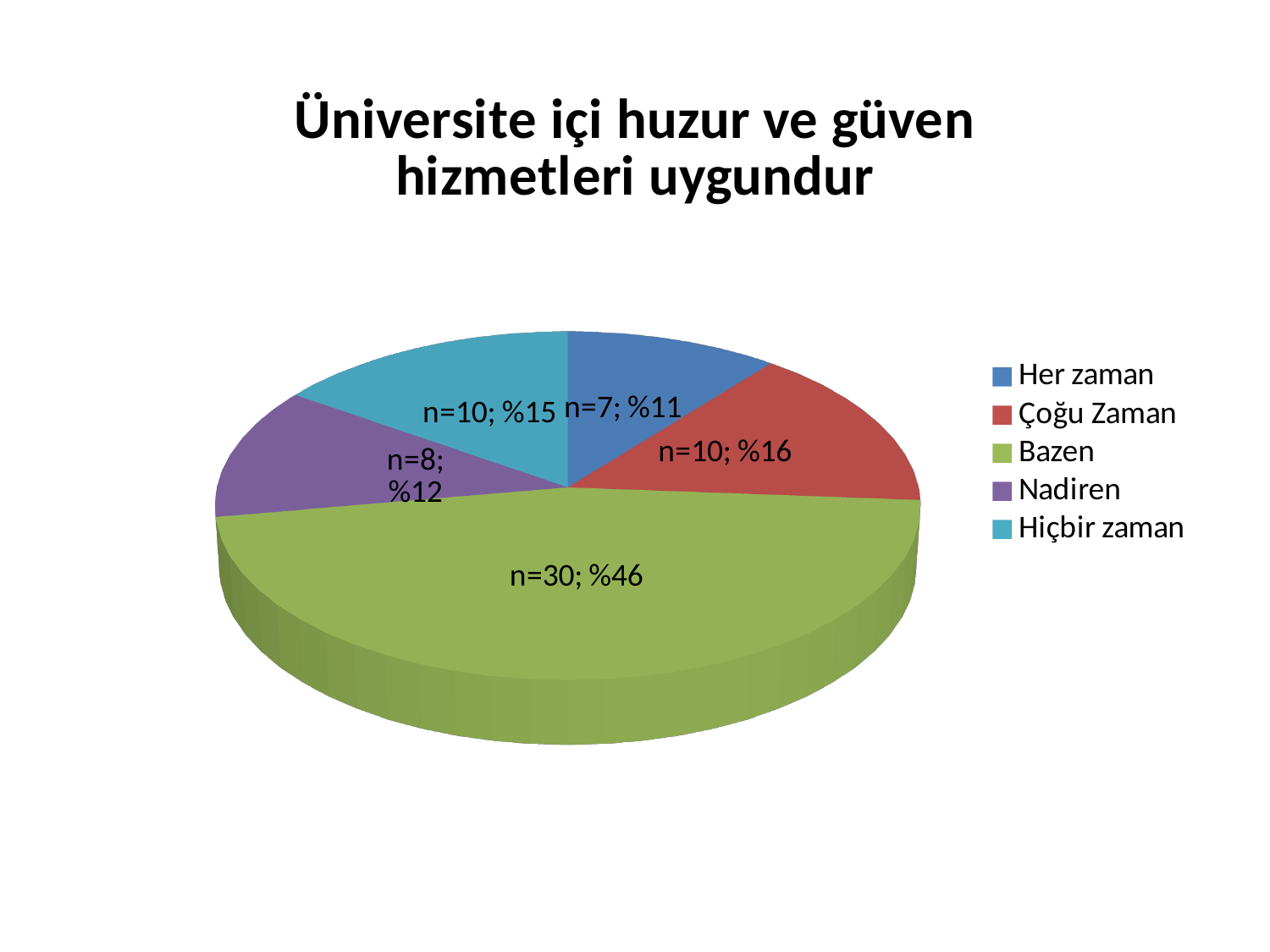
What kind of chart is shown on the slide? pie chart What percentage is shown for the Her zaman slice? %11 Which category has the smallest slice of the pie? Her zaman Which has a larger n, Çoğu Zaman or Nadiren? Çoğu Zaman How many slices does the pie chart have? 5 What is the n value for the Bazen slice? n=30 What percentage is shown for the Hiçbir zaman slice? %15 What share of the pie does the Çoğu Zaman slice represent? %16 Which category has the largest slice of the pie? Bazen What is the difference in n between Bazen and Her zaman? 23 What is the n value for the Nadiren slice? n=8 What is the title of the chart? Üniversite içi huzur ve güven hizmetleri uygundur